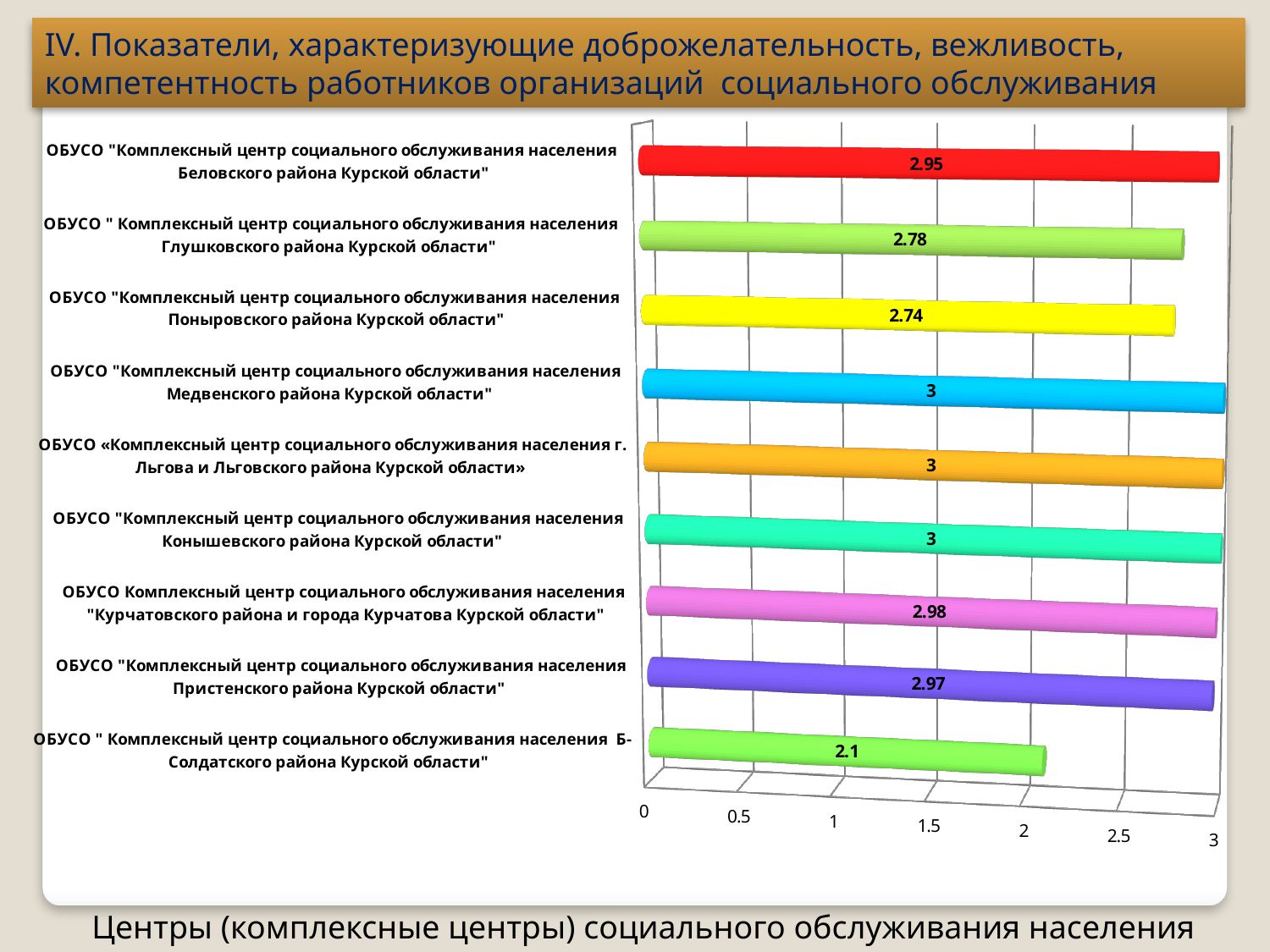
What kind of chart is shown on the slide? Bar chart How many organisations (categories) are shown on the chart? 9 What is the value for ОБУСО "Комплексный центр социального обслуживания населения Глушковского района Курской области"? 2.78 What is the value for ОБУСО "Комплексный центр социального обслуживания населения Поныровского района Курской области"? 2.74 What is the value for ОБУСО "Комплексный центр социального обслуживания населения Медвенского района Курской области"? 3 Which has a larger value: the Глушковского района centre or the Поныровского района centre? Глушковского района centre Which organisation has the lowest value on the chart? ОБУСО "Комплексный центр социального обслуживания населения Б-Солдатского района Курской области" What is the value for ОБУСО "Комплексный центр социального обслуживания населения Беловского района Курской области"? 2.95 What is the difference between the values for the Беловского района centre and the Б-Солдатского района centre? 0.85 What is the value for ОБУСО "Комплексный центр социального обслуживания населения Б-Солдатского района Курской области"? 2.1 What is the value for ОБУСО Комплексный центр социального обслуживания населения "Курчатовского района и города Курчатова Курской области"? 2.98 What is the difference between the values for the Курчатовского района centre and the Пристенского района centre? 0.01